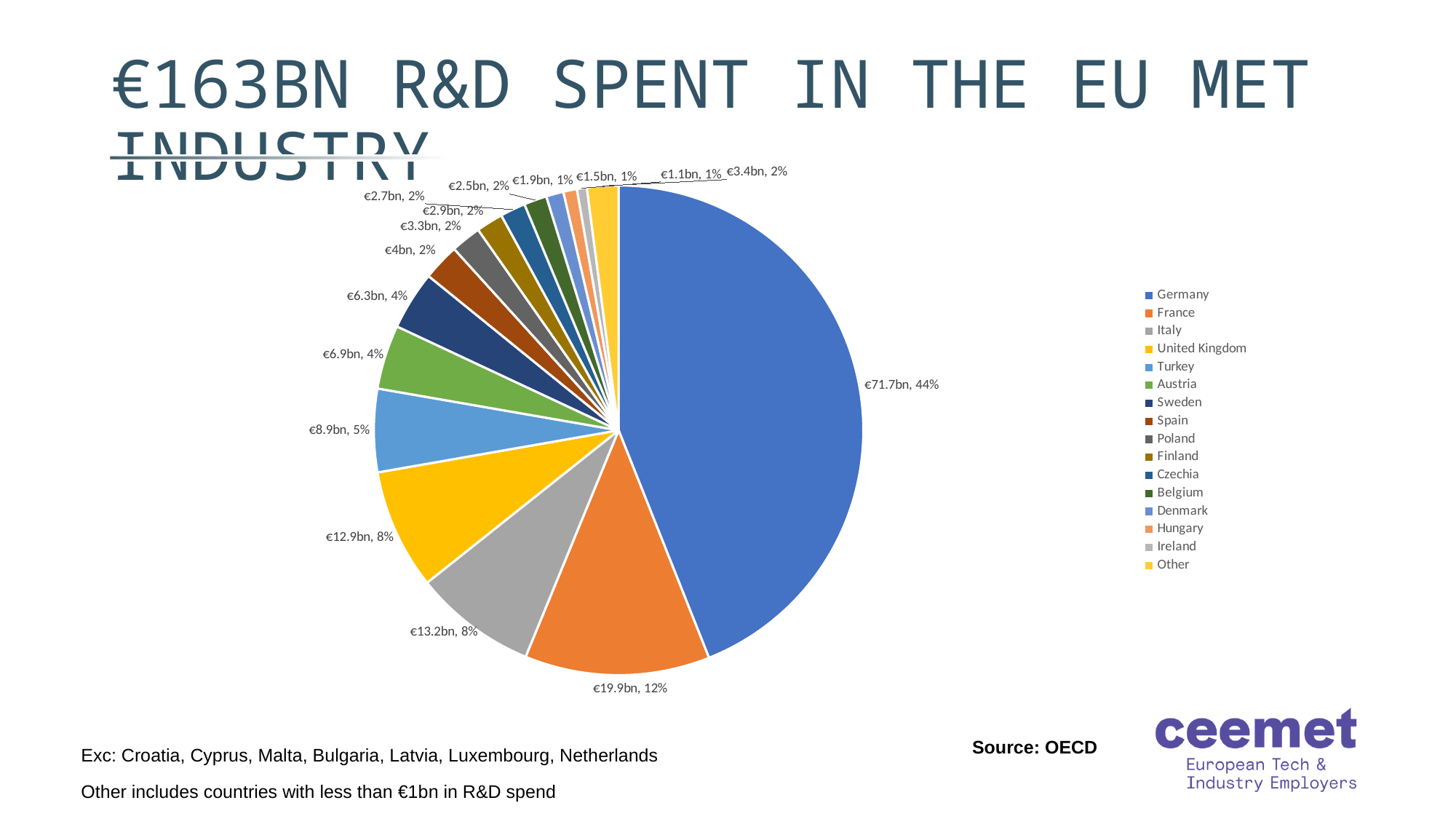
What percentage share is shown for Italy? 8% Which legend entry has the smallest slice of the pie? Ireland What is the R&D spend value shown for Germany? €71.7bn What is the title of the slide containing the chart? €163BN R&D SPENT IN THE EU MET INDUSTRY Which country has the largest slice of the pie? Germany How many entries does the legend list? 16 What is the value shown for France? €19.9bn What type of chart is shown on the slide? Pie chart What share of the pie does Germany account for? 44% What is the value shown for the United Kingdom? €12.9bn What is the difference between the values for France and Italy? €6.7bn Which is larger, the value for Turkey or the value for Austria? Turkey